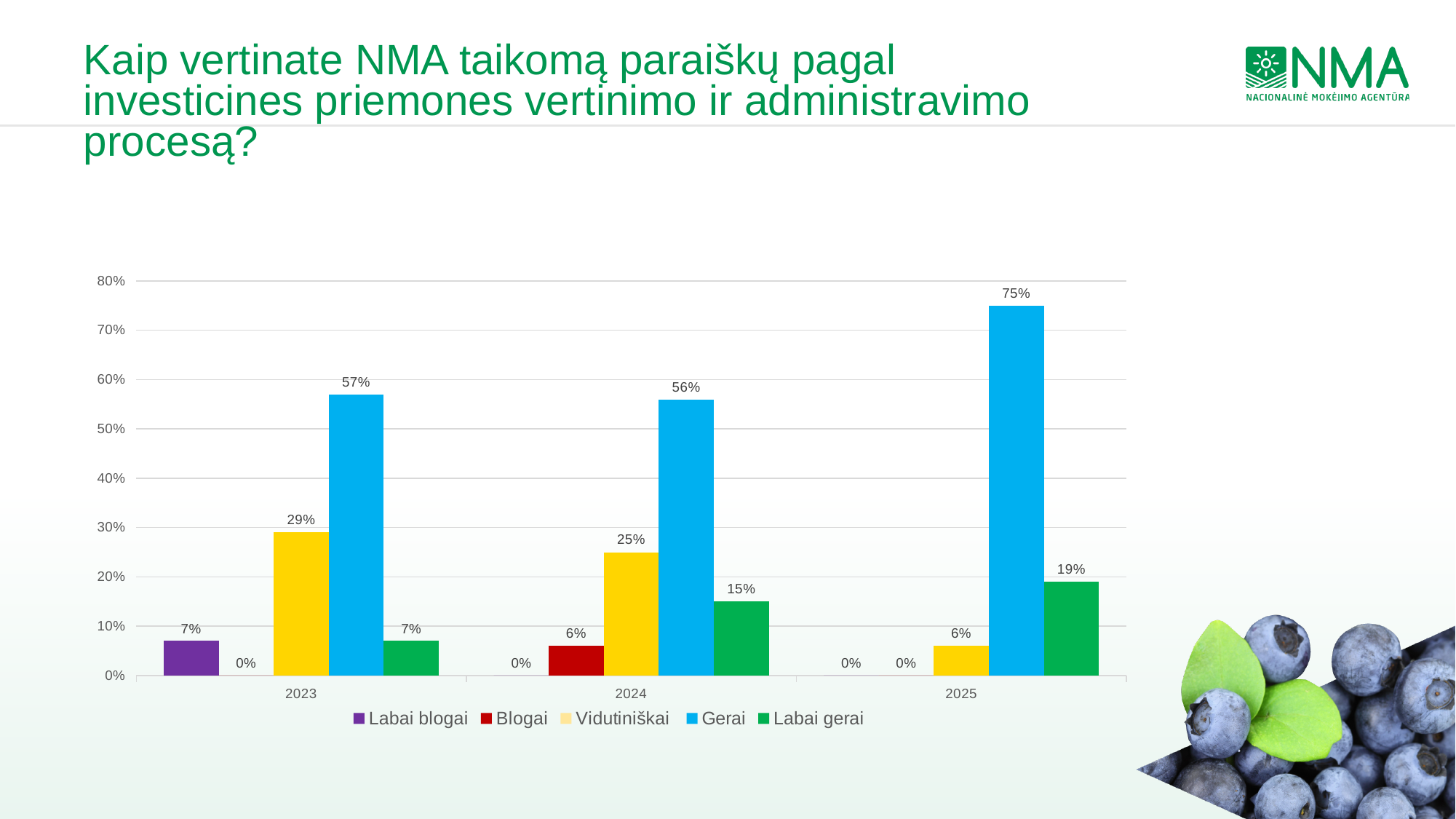
How many years are shown on the x axis? 3 Which year has the lowest value for Vidutiniškai? 2025 What is the value for Vidutiniškai in 2023? 29% Which year has the highest value for Gerai? 2025 What kind of chart is shown on the slide? Bar chart Does the value for Labai gerai rise or fall from 2023 to 2025? Rise What is the value for Labai gerai in 2024? 15% How many series does the legend list? 5 What is the value for Blogai in 2024? 6% Which is larger: Labai gerai in 2025 or Labai gerai in 2024? Labai gerai in 2025 What is the difference between the Gerai values for 2025 and 2024? 19% What is the value for Gerai in 2025? 75%